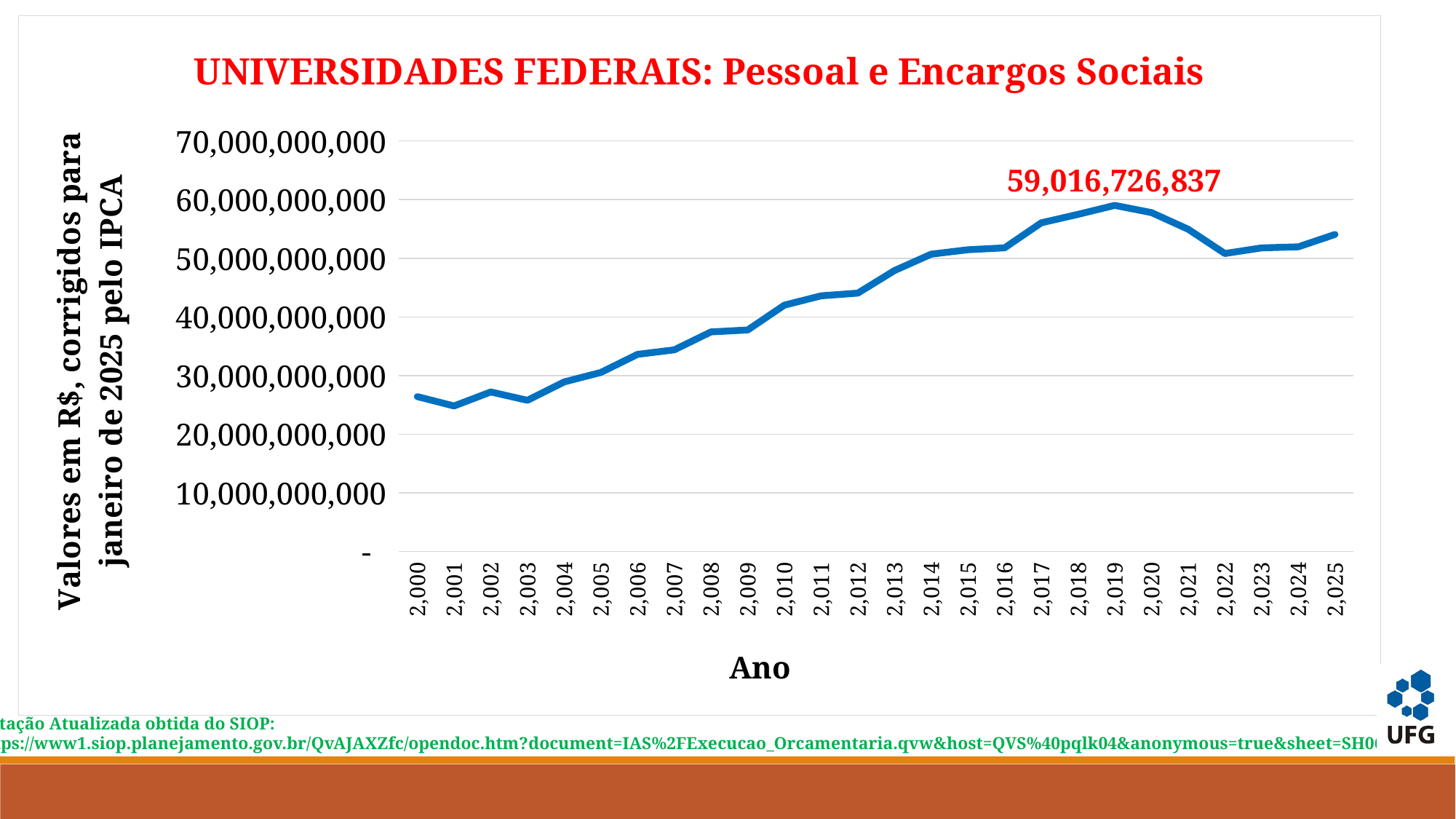
Is the value for 2000 greater or less than 30,000,000,000? less How many years (data points) are plotted along the x axis? 26 Is the value for 2013 greater or less than 50,000,000,000? less Which year has the highest value on the chart? 2019 Is the value for 2017 greater or less than 50,000,000,000? greater What kind of chart is shown on the slide? line chart Do the values rise or fall from 2019 to 2022? fall Which year has the larger value, 2019 or 2025? 2019 Do the values generally rise or fall from 2000 to 2019? rise What is the value labelled on the chart for the year 2019? 59,016,726,837 What is the title of the chart? UNIVERSIDADES FEDERAIS: Pessoal e Encargos Sociais